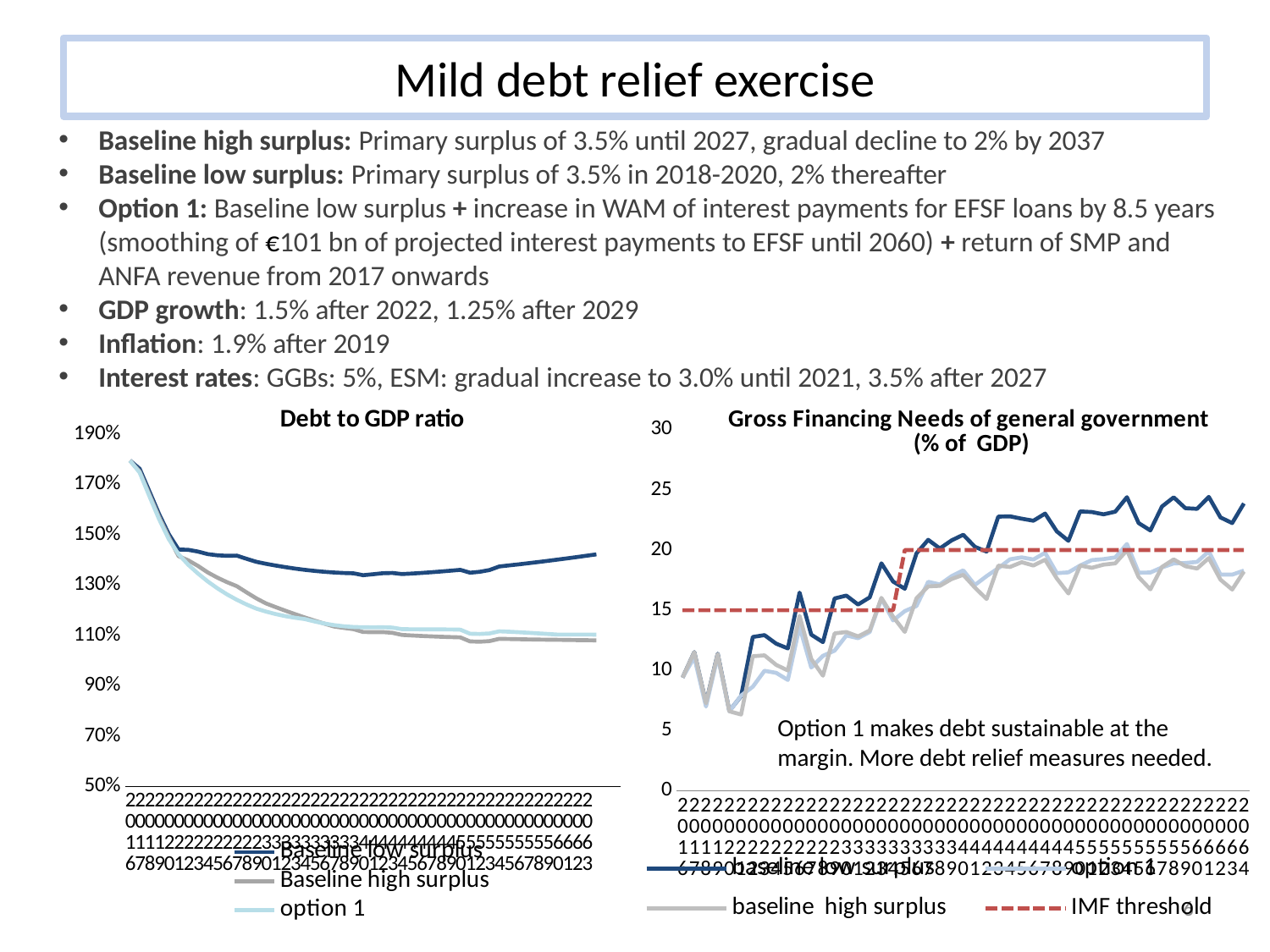
In the 'Gross Financing Needs of general government (% of GDP)' chart, which series is drawn as a dashed line? IMF threshold In the 'Debt to GDP ratio' chart, how many series does the legend list? 3 What kind of chart is the 'Gross Financing Needs of general government (% of GDP)' chart? line chart In the 'Debt to GDP ratio' chart, at the right end of the chart, which is higher: 'Baseline low surplus' or 'Baseline high surplus'? Baseline low surplus In the 'Gross Financing Needs of general government (% of GDP)' chart, is the 'IMF threshold' line at the right end of the chart greater or less than 15? greater In the 'Gross Financing Needs of general government (% of GDP)' chart, does the 'baseline low surplus' line rise or fall overall along the x axis? rise In the 'Gross Financing Needs of general government (% of GDP)' chart, at the right end of the chart, which is higher: 'baseline low surplus' or 'baseline high surplus'? baseline low surplus In the 'Gross Financing Needs of general government (% of GDP)' chart, how many series does the legend list? 4 In the 'Debt to GDP ratio' chart, does the 'Baseline high surplus' line rise or fall along the x axis? fall In the 'Debt to GDP ratio' chart, is the starting value of the lines at the left end greater or less than 170%? greater In the 'Debt to GDP ratio' chart, is the value of 'Baseline low surplus' at the right end of the chart greater or less than 130%? greater What kind of chart is the 'Debt to GDP ratio' chart? line chart